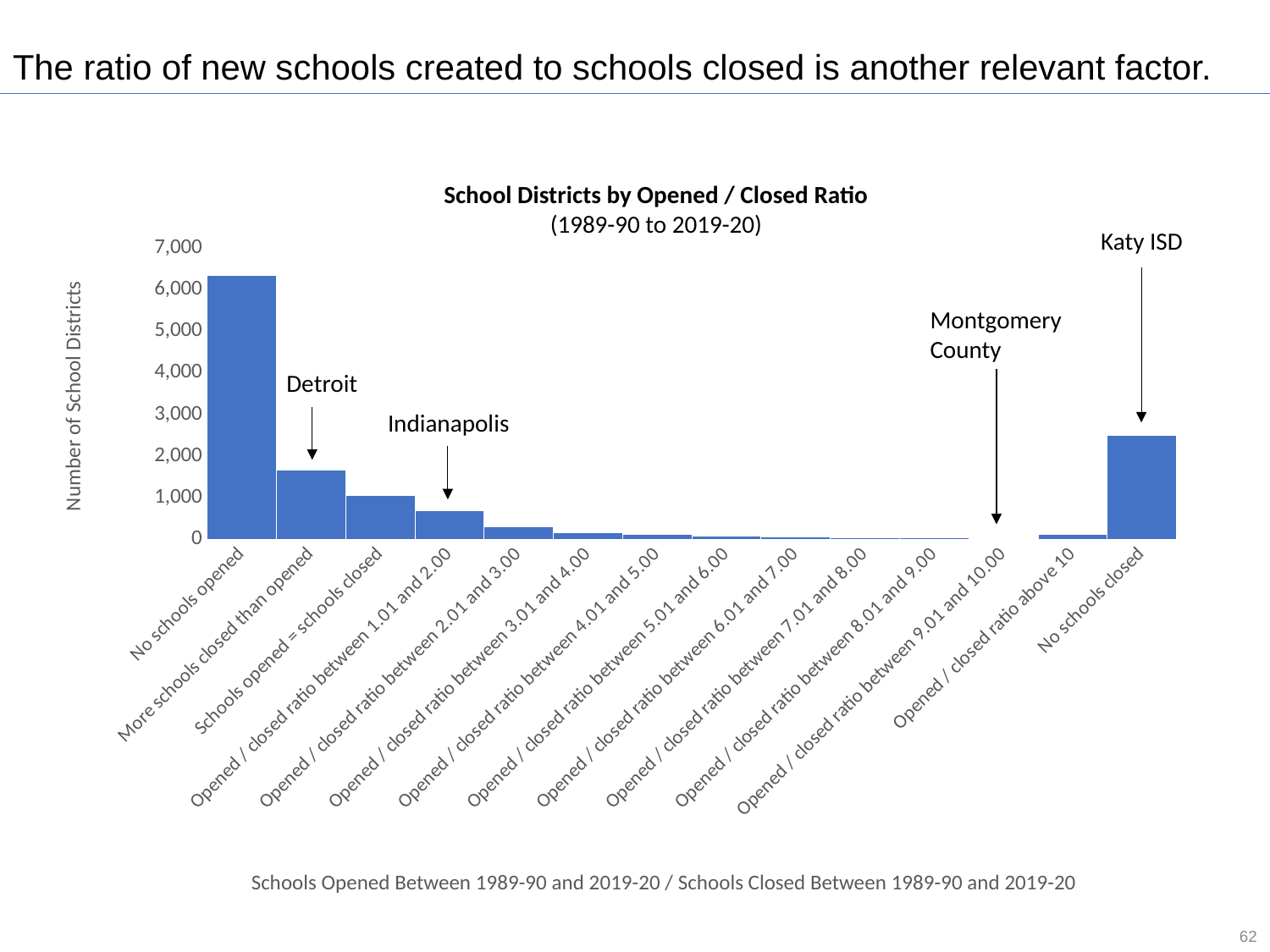
How many categories are shown on the x axis of the chart? 14 What kind of chart is shown on the slide? bar chart Do the values rise or fall from "No schools opened" through "Opened / closed ratio between 9.01 and 10.00"? fall Which has more school districts: "Opened / closed ratio between 2.01 and 3.00" or "Opened / closed ratio between 1.01 and 2.00"? Opened / closed ratio between 1.01 and 2.00 Which school district is annotated with an arrow pointing to the "No schools closed" bar? Katy ISD Is the value for "More schools closed than opened" greater or less than 2,000? less Which category has the highest number of school districts? No schools opened Which has more school districts: "No schools closed" or "More schools closed than opened"? No schools closed Is the value for "Opened / closed ratio between 1.01 and 2.00" greater or less than 1,000? less What is the title of the chart? School Districts by Opened / Closed Ratio (1989-90 to 2019-20) Is the value for "No schools opened" greater or less than 6,000? greater